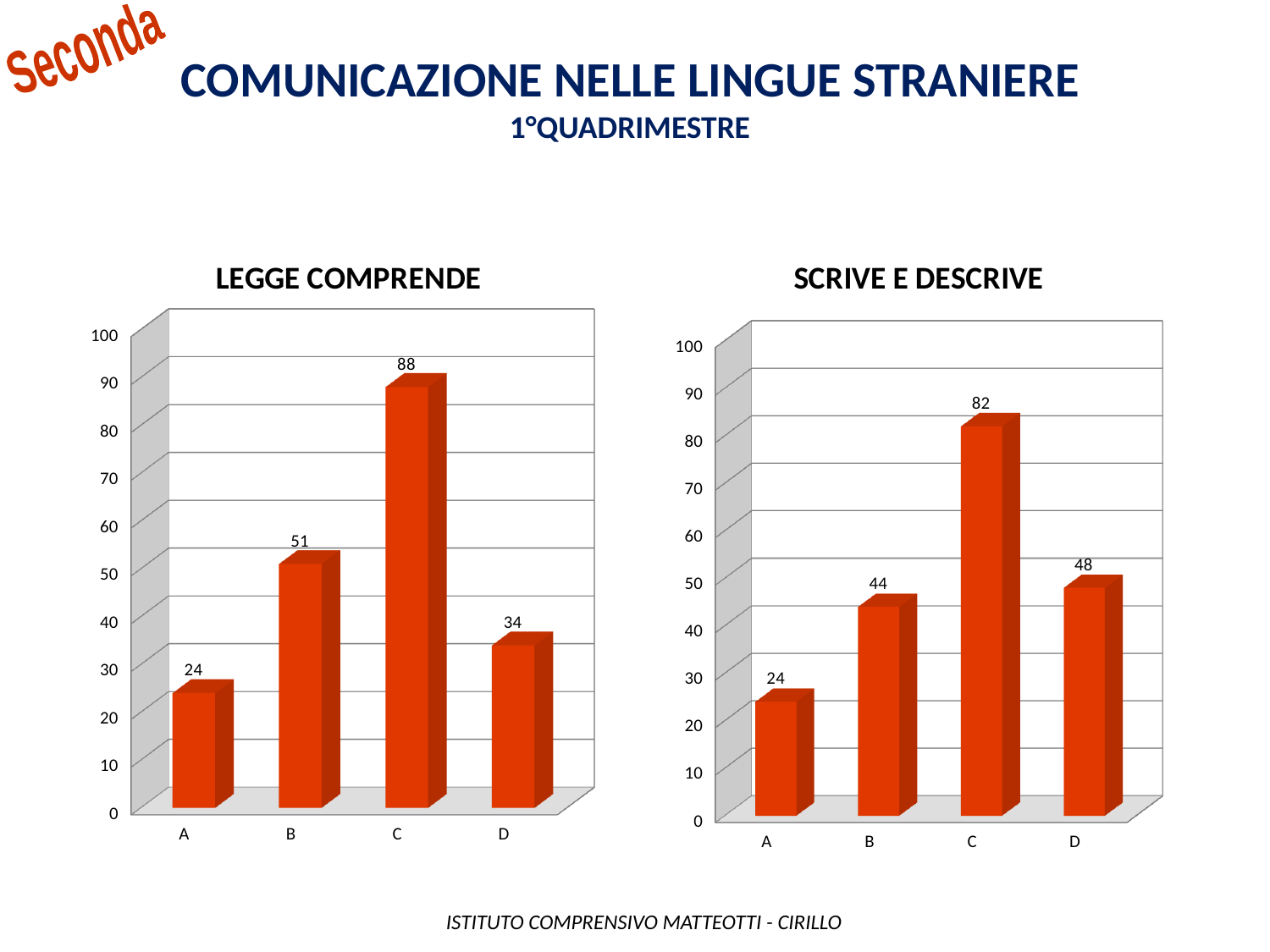
What is the title of the chart on the right side of the slide? SCRIVE E DESCRIVE In the SCRIVE E DESCRIVE chart, what is the value for category B? 44 In the SCRIVE E DESCRIVE chart, which is larger, the value for B or the value for D? D In the SCRIVE E DESCRIVE chart, which category has the highest value? C In the LEGGE COMPRENDE chart, is the value for D greater or less than 40? less In the LEGGE COMPRENDE chart, what is the difference between the values for C and B? 37 In the LEGGE COMPRENDE chart, what is the value for category C? 88 In the LEGGE COMPRENDE chart, which category has the lowest value? A In the SCRIVE E DESCRIVE chart, what is the difference between the values for D and A? 24 How many categories are shown in the SCRIVE E DESCRIVE chart? 4 In the LEGGE COMPRENDE chart, what is the value for category D? 34 What kind of chart is the LEGGE COMPRENDE chart? bar chart